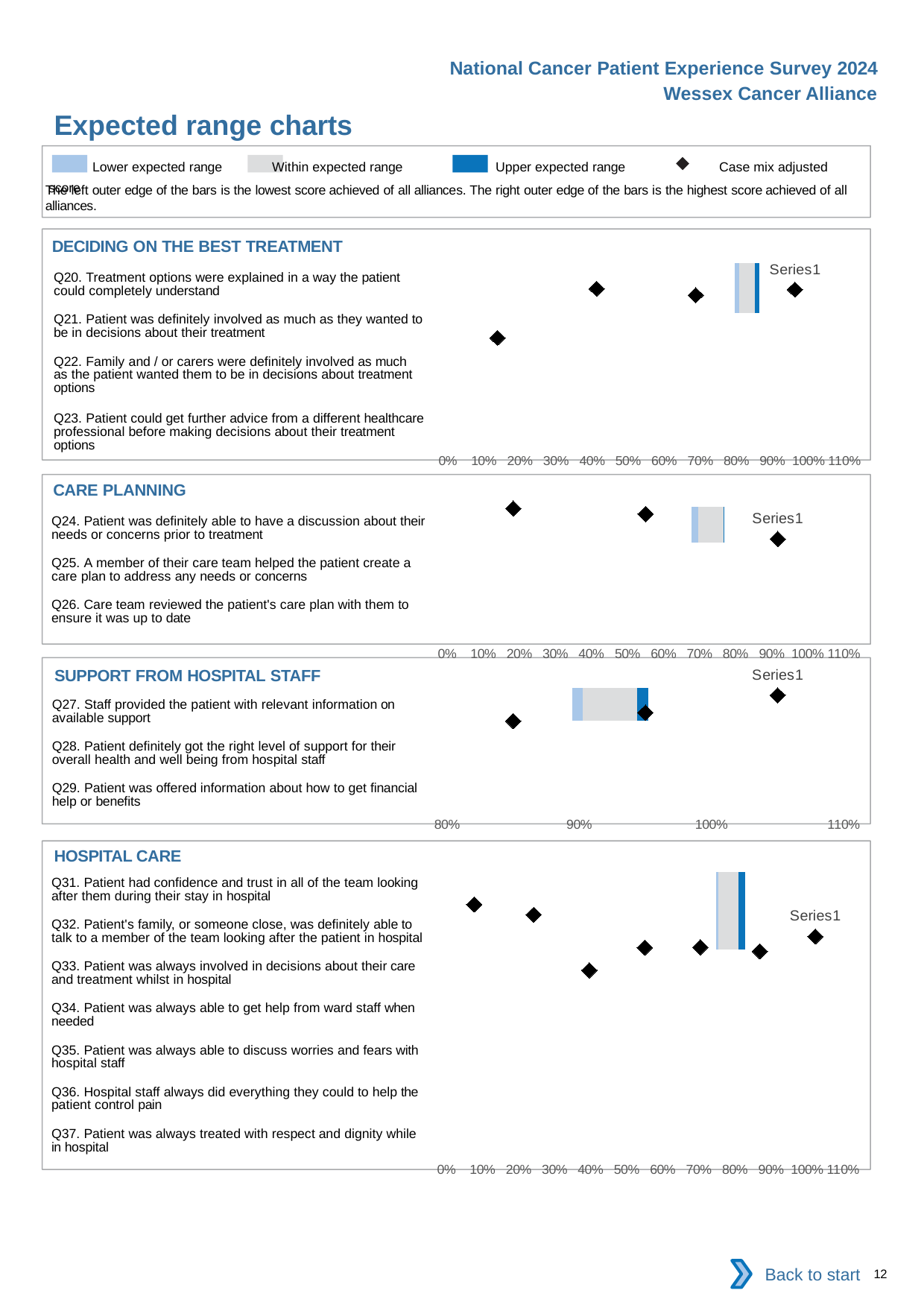
In the CARE PLANNING chart, is the lowest diamond marker greater or less than 30%? less In the SUPPORT FROM HOSPITAL STAFF chart, what is the lowest value shown on the x axis? 80% In the DECIDING ON THE BEST TREATMENT chart, how many series does the legend list? 1 In the HOSPITAL CARE chart, what is the name of the series shown in the legend? Series1 In the DECIDING ON THE BEST TREATMENT chart, is the lowest diamond marker greater or less than 20%? less How many question items are listed in the DECIDING ON THE BEST TREATMENT chart? 4 How many diamond markers are plotted in the SUPPORT FROM HOSPITAL STAFF chart? 2 How many diamond markers are plotted in the HOSPITAL CARE chart? 6